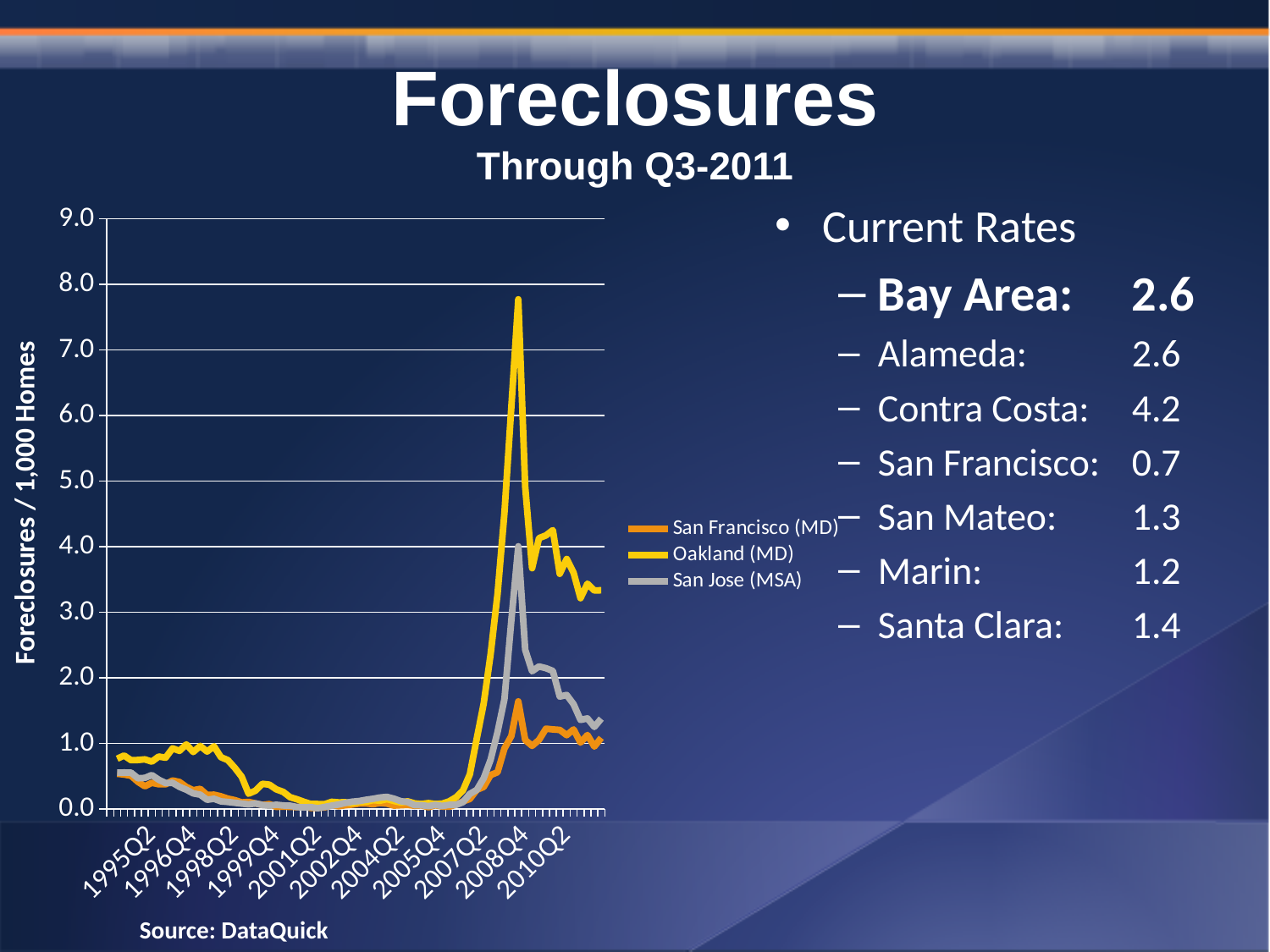
Which series has the lowest peak on the chart? San Francisco (MD) Is the peak value for San Francisco (MD) greater or less than 2.0? less What is the highest value shown on the chart's vertical axis? 9.0 Around 2008Q4, which series is higher: Oakland (MD) or San Jose (MSA)? Oakland (MD) Is the peak value for San Jose (MSA) greater or less than 3.0? greater Which series reaches the highest peak on the chart? Oakland (MD) Does the Oakland (MD) line rise or fall between 2005Q4 and 2008Q4? rise How many series does the chart's legend list? 3 What is the label of the chart's vertical axis? Foreclosures / 1,000 Homes Does the Oakland (MD) line rise or fall between 1998Q2 and 2001Q2? fall What kind of chart is shown on the slide? line chart Is the peak value for Oakland (MD) greater or less than 7.0? greater